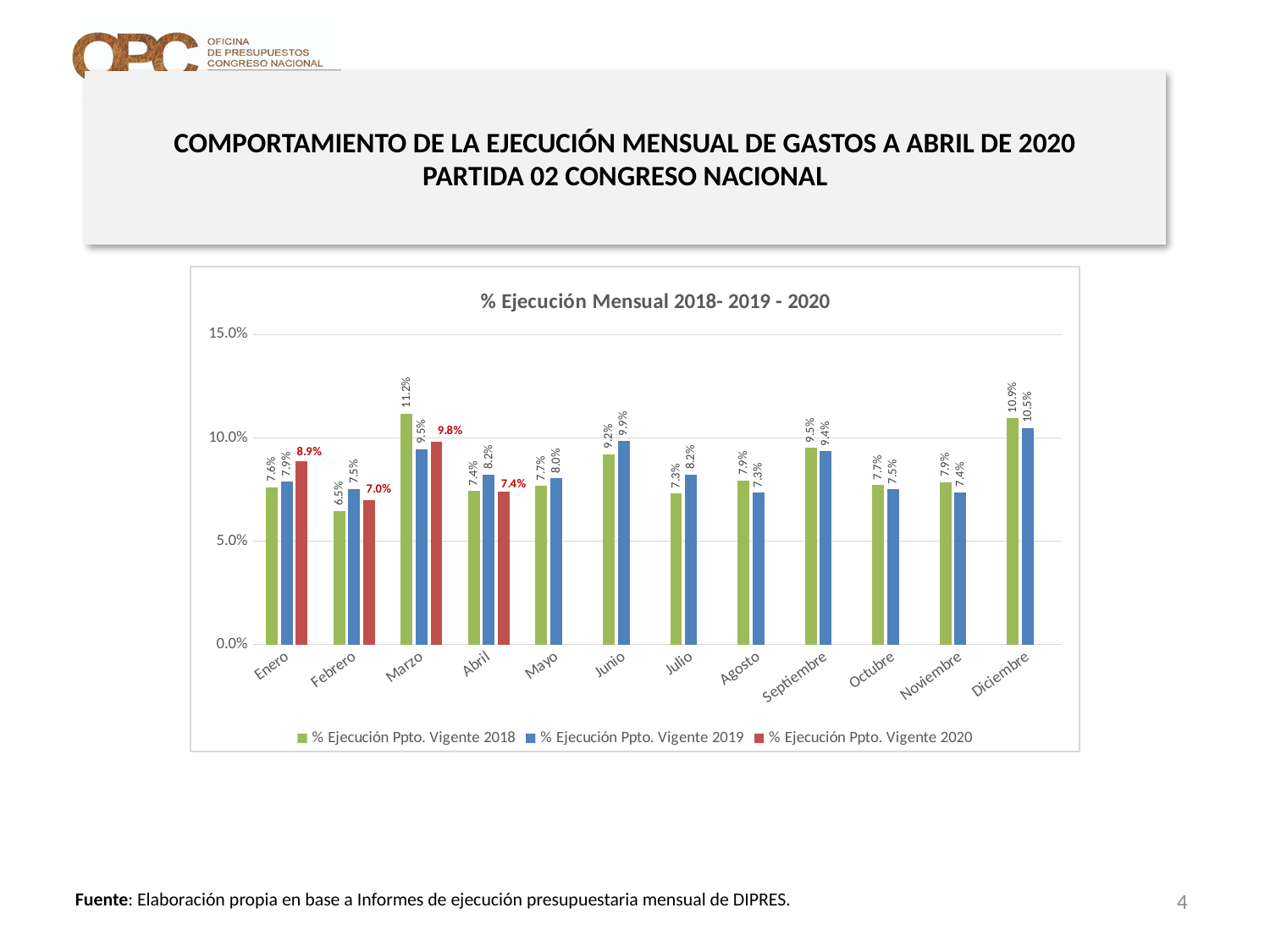
What is the value for % Ejecución Ppto. Vigente 2020 in Enero? 8.9% How many months are shown on the x axis? 12 Which month has the highest value for % Ejecución Ppto. Vigente 2018? Marzo Which month has the lowest value for % Ejecución Ppto. Vigente 2018? Febrero In Febrero, which is larger: the 2019 value or the 2020 value? 2019 How many series does the legend list? 3 What is the difference between the 2018 and 2019 values in Marzo? 1.7% What is the title of the chart? % Ejecución Mensual 2018- 2019 - 2020 Is the value for % Ejecución Ppto. Vigente 2019 in Junio greater or less than 5.0%? greater What is the value for % Ejecución Ppto. Vigente 2018 in Marzo? 11.2% What type of chart is shown on the slide? bar chart What is the value for % Ejecución Ppto. Vigente 2019 in Diciembre? 10.5%